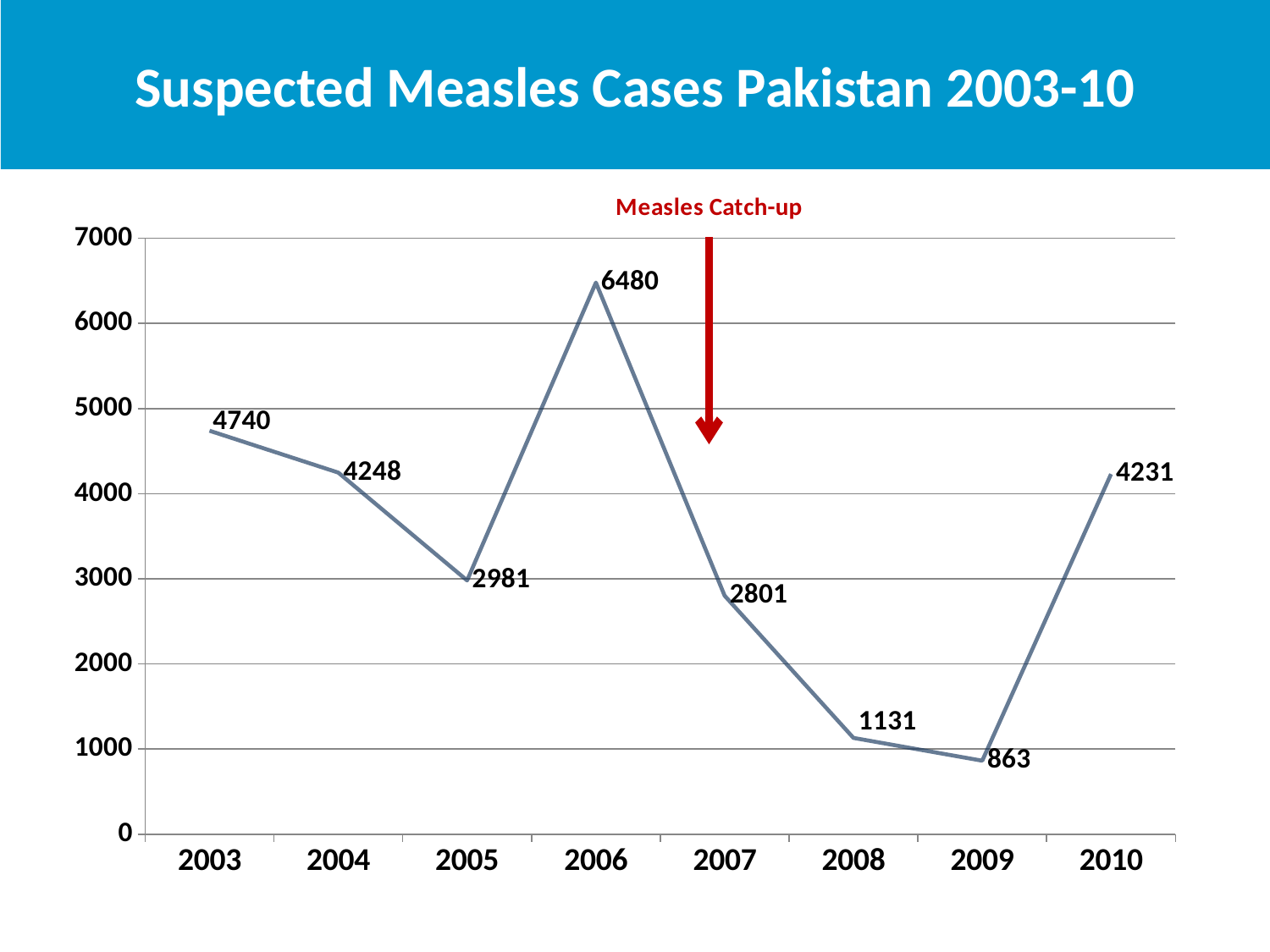
Which year had more suspected measles cases, 2003 or 2010? 2003 What is the difference in suspected measles cases between 2003 and 2004? 492 Is the value for 2008 greater or less than 2000? less What kind of chart is shown on the slide? line chart What event does the red arrow on the chart mark? Measles Catch-up What is the number of suspected measles cases in 2009? 863 How many years are plotted on the chart? 8 Which year has the lowest number of suspected measles cases? 2009 Which year has the highest number of suspected measles cases? 2006 What is the number of suspected measles cases in 2010? 4231 What is the number of suspected measles cases in 2006? 6480 What is the difference in suspected measles cases between 2006 and 2007? 3679